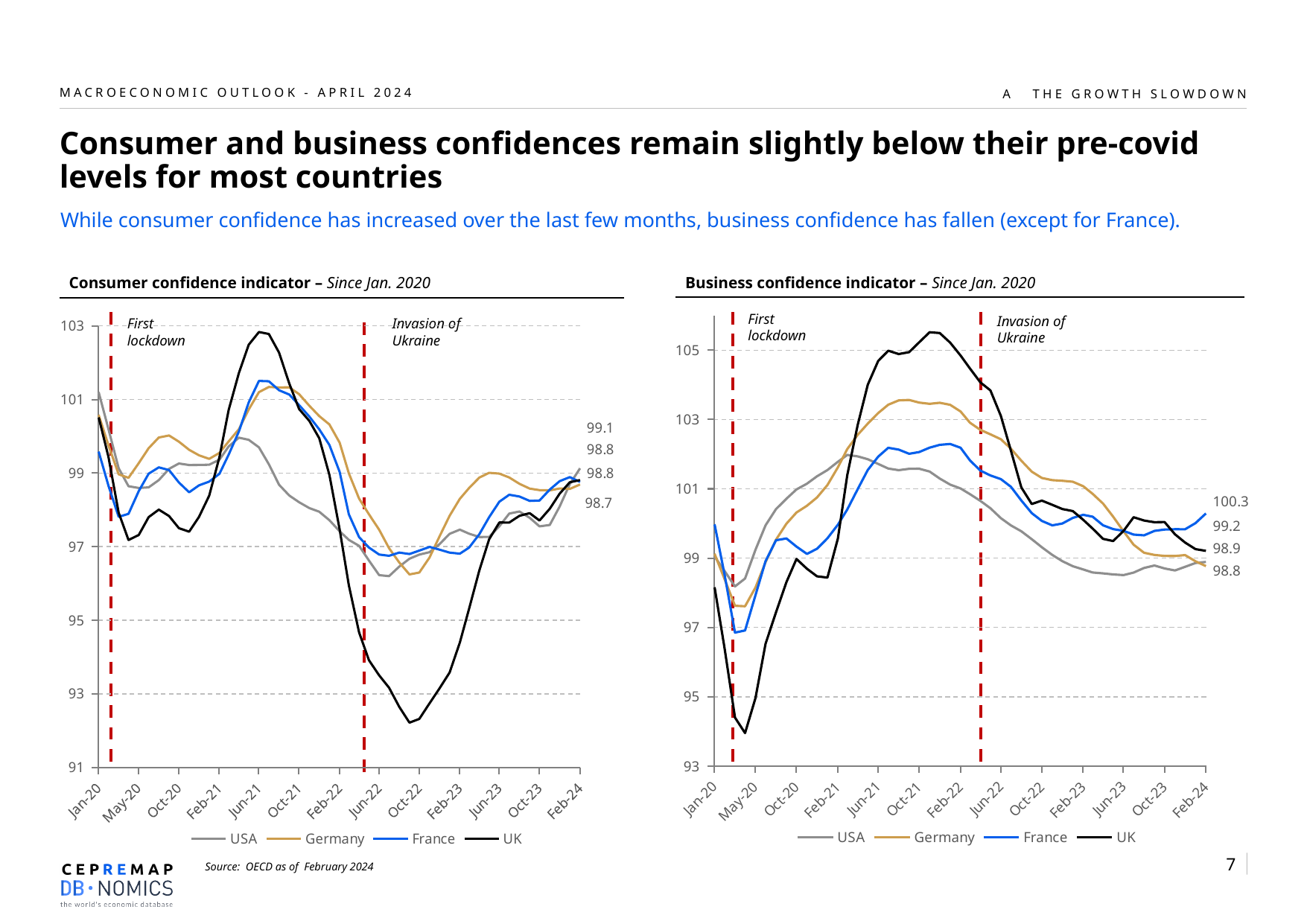
In the Consumer confidence indicator chart, which country falls to the lowest value over the period? UK In the Business confidence indicator chart, is the peak value for Germany around Oct-21 greater or less than 103? greater In the Consumer confidence indicator chart, what is the value labelled for the USA at Feb-24? 99.1 In the Consumer confidence indicator chart, is the value for the UK around Oct-22 greater or less than 93? less What two events do the red dashed vertical lines mark on the Business confidence indicator chart? First lockdown and Invasion of Ukraine Which countries are listed in the legend of the Consumer confidence indicator chart? USA, Germany, France, UK How many series does the legend of the Business confidence indicator chart list? 4 What kind of chart is the Consumer confidence indicator chart? Line chart In the Business confidence indicator chart, which country reaches the highest value over the period? UK In the Business confidence indicator chart, what is the value labelled for France at Feb-24? 100.3 In the Business confidence indicator chart, at Feb-24 which is larger, the value for France or the value for the USA? France In the Consumer confidence indicator chart, does the UK line rise or fall between Jun-21 and Oct-22? Fall